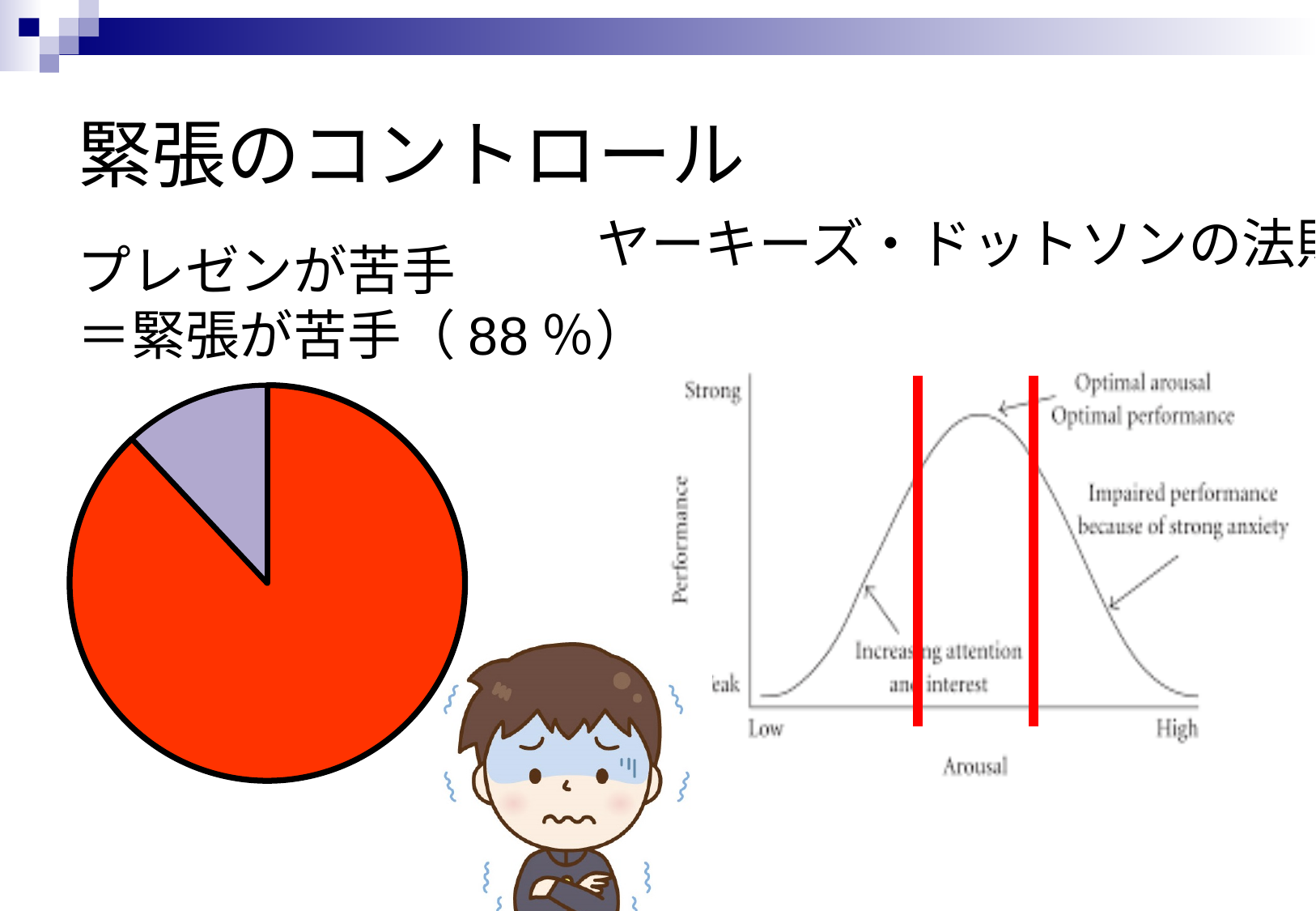
In the chart on the right, what is the label of the y axis? Performance In the chart on the right, what is the label of the x axis? Arousal What kind of chart is shown on the left of the slide? pie chart In the pie chart on the left, what share of the pie does the red slice (緊張が苦手) represent? 88％ How many slices does the pie chart on the left have? 2 In the pie chart on the left, is the purple slice greater or less than 50% of the pie? less In the chart on the right, is performance at Low arousal greater or less than performance at the optimal arousal point? less In the chart on the right, at which level of arousal is performance highest: low, middle, or high? middle In the pie chart on the left, which slice is larger, the red one or the purple one? the red one In the chart on the right, what label is given to the peak of the curve? Optimal arousal / Optimal performance In the chart on the right, how does performance change as arousal increases from Low to High? it rises, then falls What kind of chart is the Yerkes-Dodson diagram on the right? line chart